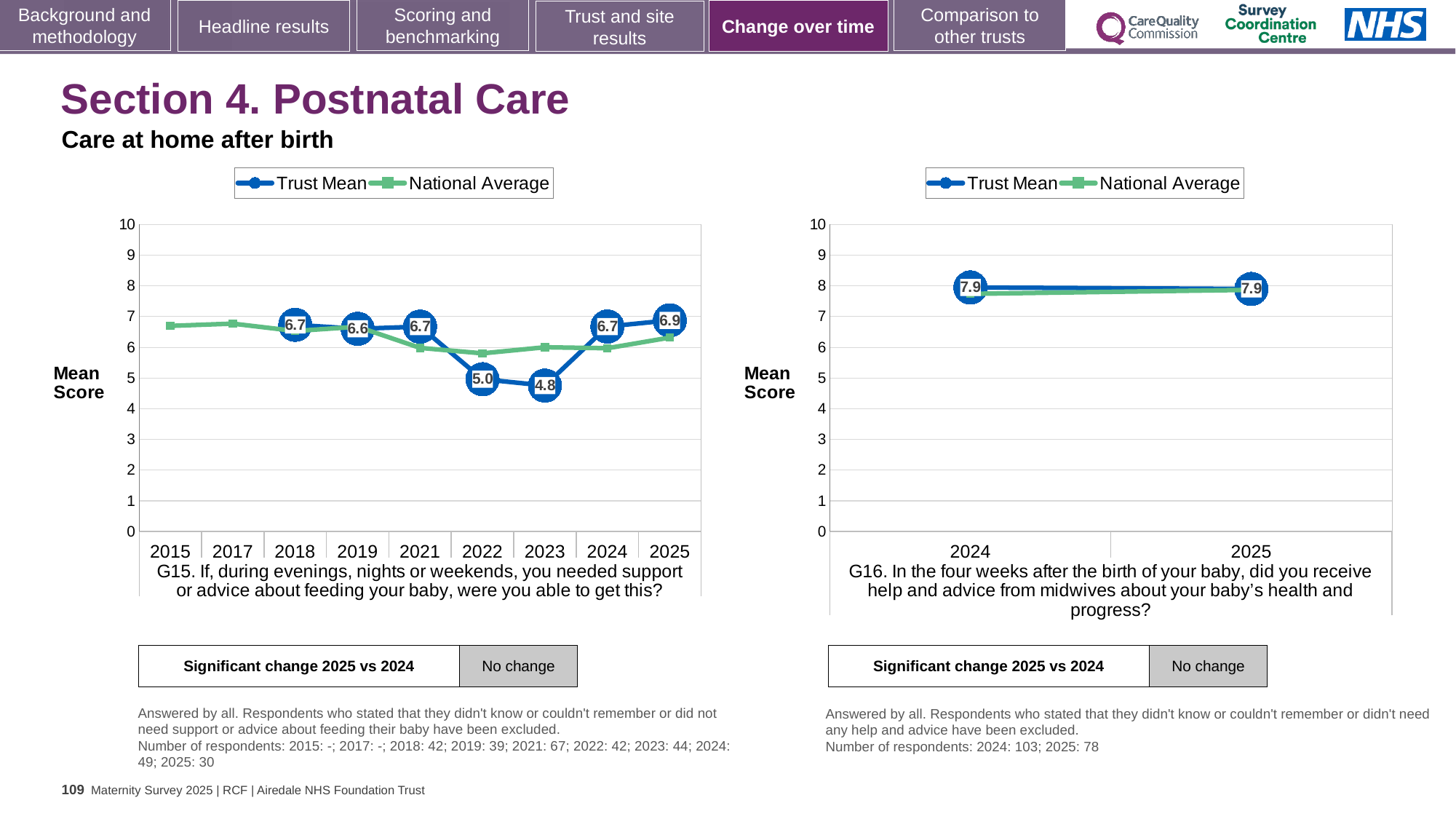
On the left chart (G15), is the Trust Mean for 2024 or for 2022 larger? 2024 On the left chart (G15), which year has the highest Trust Mean? 2025 On the left chart (G15), what is the Trust Mean for 2022? 5.0 On the left chart (G15), what is the Trust Mean for 2023? 4.8 What kind of chart is the right chart (G16)? line chart On the left chart (G15), which year has the lowest Trust Mean? 2023 On the left chart (G15), what is the Trust Mean for 2025? 6.9 On the right chart (G16), how many series does the legend list? 2 On the left chart (G15), how many years are shown on the x axis? 9 On the left chart (G15), what is the difference between the Trust Mean for 2025 and the Trust Mean for 2023? 2.1 On the left chart (G15), is the National Average for 2022 greater or less than 7? less On the right chart (G16), what is the Trust Mean for 2025? 7.9